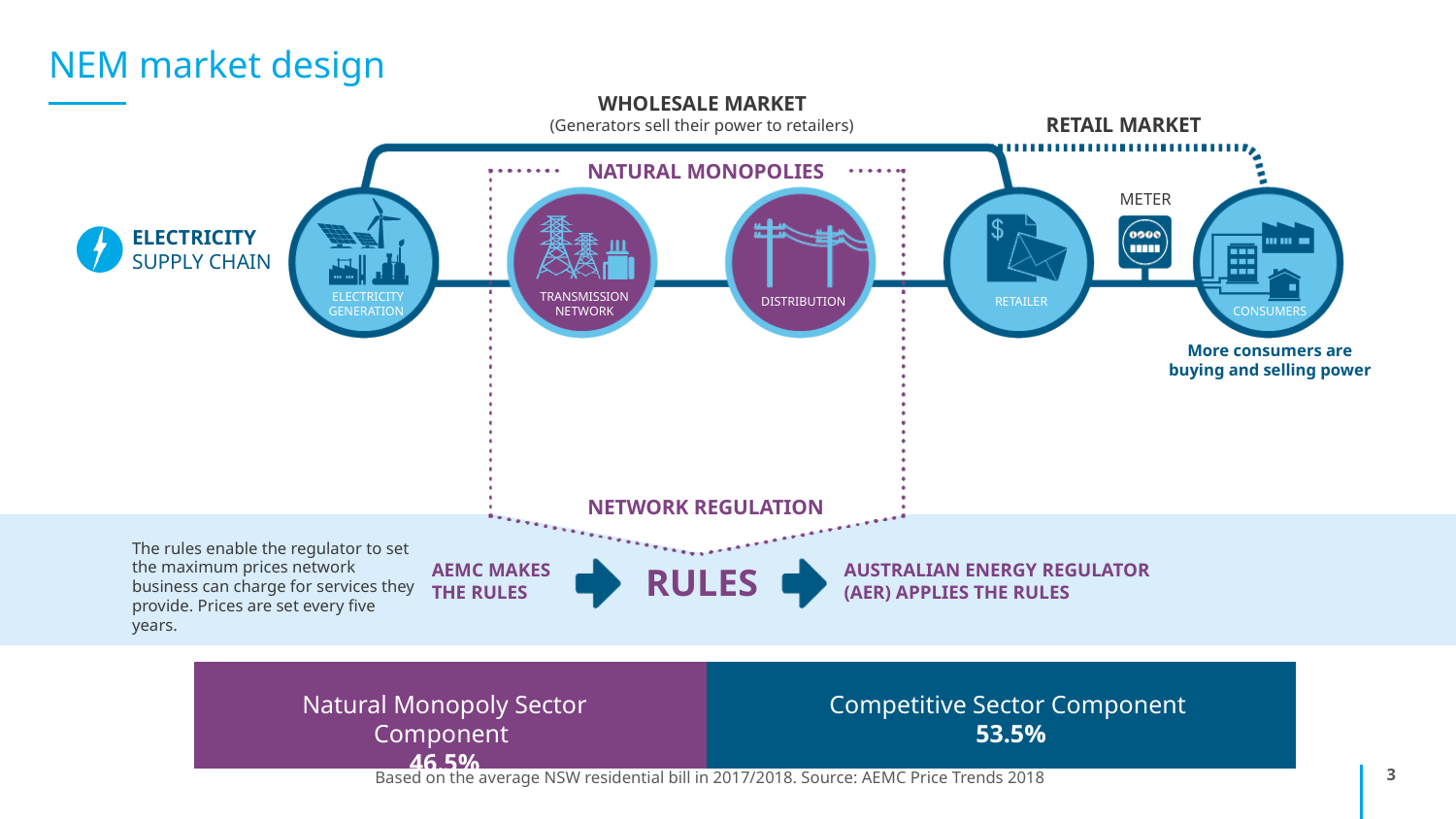
In the bar at the bottom of the slide, which component has the smaller share? Natural Monopoly Sector Component In the bar at the bottom of the slide, what is the difference between the Competitive Sector Component and the Natural Monopoly Sector Component? 7.0% In the bar at the bottom of the slide, what is the value for the Natural Monopoly Sector Component? 46.5% What colour is the Natural Monopoly Sector Component segment in the bar at the bottom of the slide? Purple What kind of chart is shown at the bottom of the slide? Stacked bar chart According to the note under the bar at the bottom of the slide, what is the data based on? The average NSW residential bill in 2017/2018 In the bar at the bottom of the slide, which component has the larger share? Competitive Sector Component In the bar at the bottom of the slide, is the Natural Monopoly Sector Component larger or smaller than the Competitive Sector Component? smaller In the bar at the bottom of the slide, what is the value for the Competitive Sector Component? 53.5% How many components are shown in the bar at the bottom of the slide? 2 What is the total of the two components in the bar at the bottom of the slide? 100% In the bar at the bottom of the slide, is the value for the Competitive Sector Component greater or less than 50%? greater